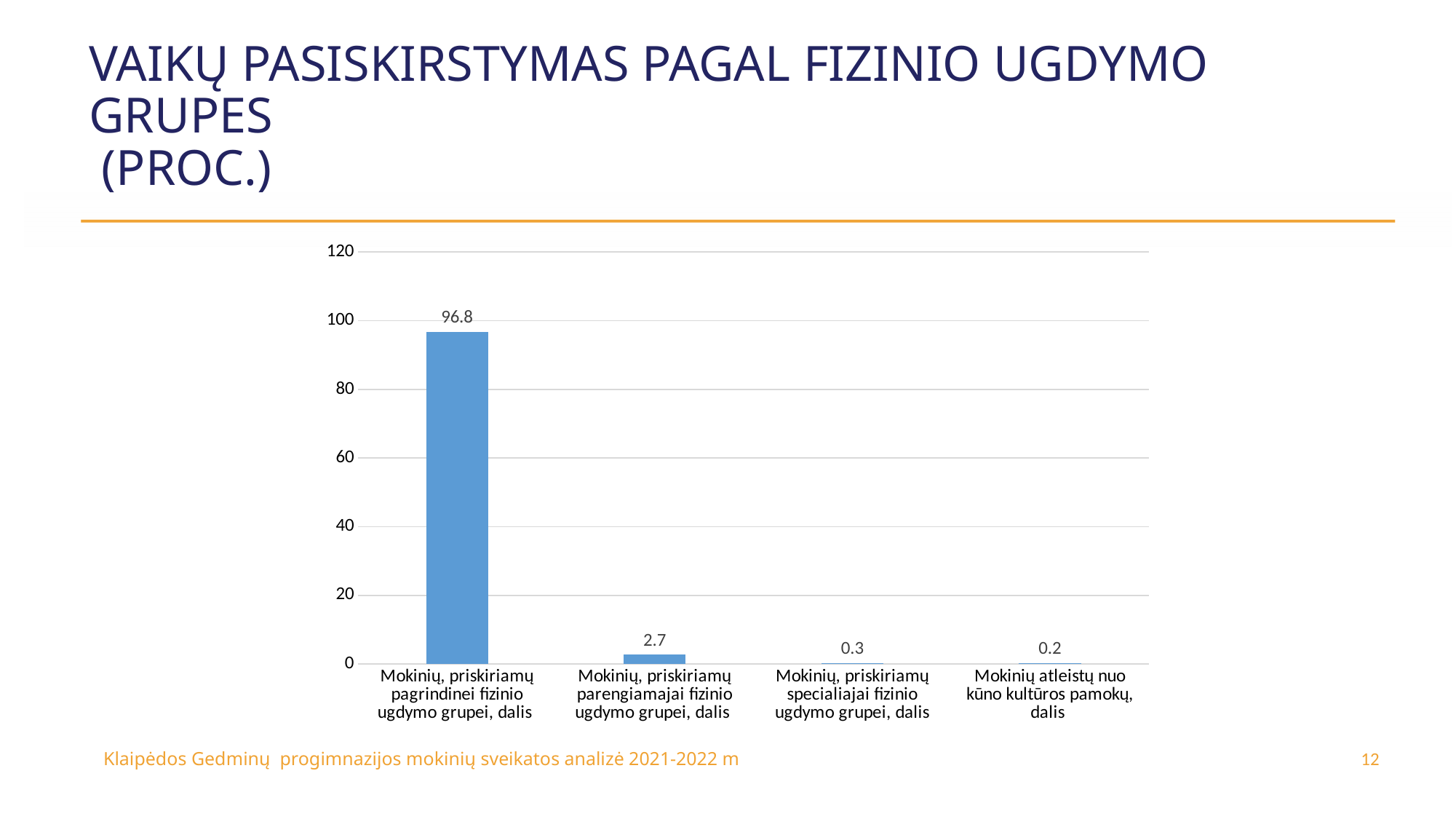
What kind of chart is shown on the slide? bar chart What is the value for 'Mokinių, priskiriamų specialiajai fizinio ugdymo grupei, dalis'? 0.3 Do the values rise or fall from left to right along the x axis? fall Is the value for 'Mokinių, priskiriamų pagrindinei fizinio ugdymo grupei, dalis' greater or less than 80? greater How many categories are shown on the chart? 4 What is the value for 'Mokinių, priskiriamų parengiamajai fizinio ugdymo grupei, dalis'? 2.7 What is the difference between the values for 'Mokinių, priskiriamų pagrindinei fizinio ugdymo grupei, dalis' and 'Mokinių, priskiriamų parengiamajai fizinio ugdymo grupei, dalis'? 94.1 Which category has the highest value? Mokinių, priskiriamų pagrindinei fizinio ugdymo grupei, dalis What is the value for 'Mokinių atleistų nuo kūno kultūros pamokų, dalis'? 0.2 Which category has the lowest value? Mokinių atleistų nuo kūno kultūros pamokų, dalis Which is larger: the value for 'Mokinių, priskiriamų parengiamajai fizinio ugdymo grupei, dalis' or 'Mokinių, priskiriamų specialiajai fizinio ugdymo grupei, dalis'? Mokinių, priskiriamų parengiamajai fizinio ugdymo grupei, dalis What is the value for 'Mokinių, priskiriamų pagrindinei fizinio ugdymo grupei, dalis'? 96.8